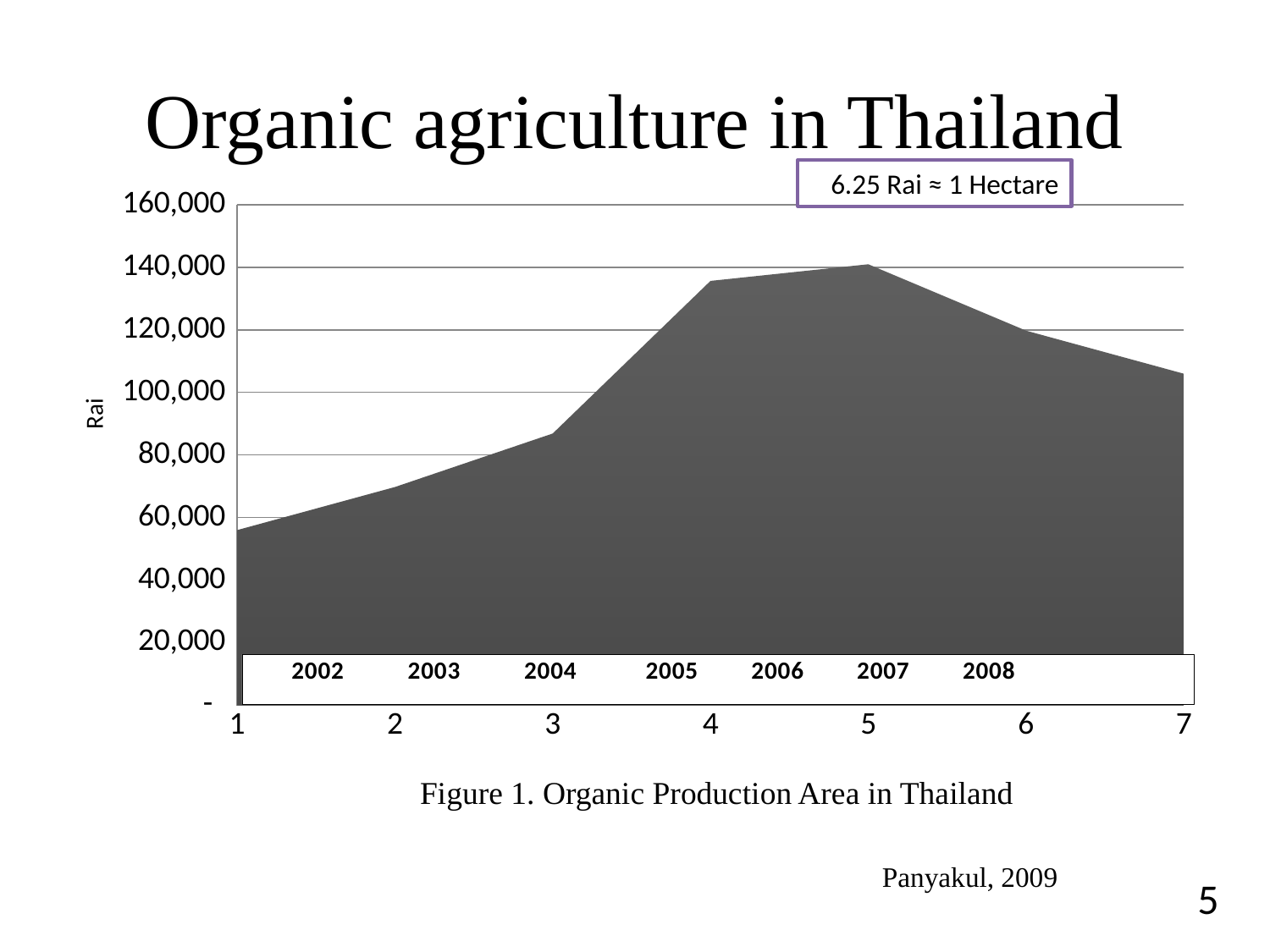
At which x-axis position is the chart's value lowest? 1 Is the value at x-axis position 7 greater or less than 100,000? greater Is the value at x-axis position 3 greater or less than 80,000? greater How many data points are plotted along the x axis of the chart? 7 Which has the larger value: x-axis position 2 or x-axis position 4? 4 Is the value at x-axis position 4 greater or less than 120,000? greater Does the plotted value rise or fall from x-axis position 1 to x-axis position 5? rise At which x-axis position does the chart reach its highest value? 5 What is the figure caption shown below the chart? Figure 1. Organic Production Area in Thailand What is the label on the vertical axis of the chart? Rai What kind of chart is shown on the slide? Area chart